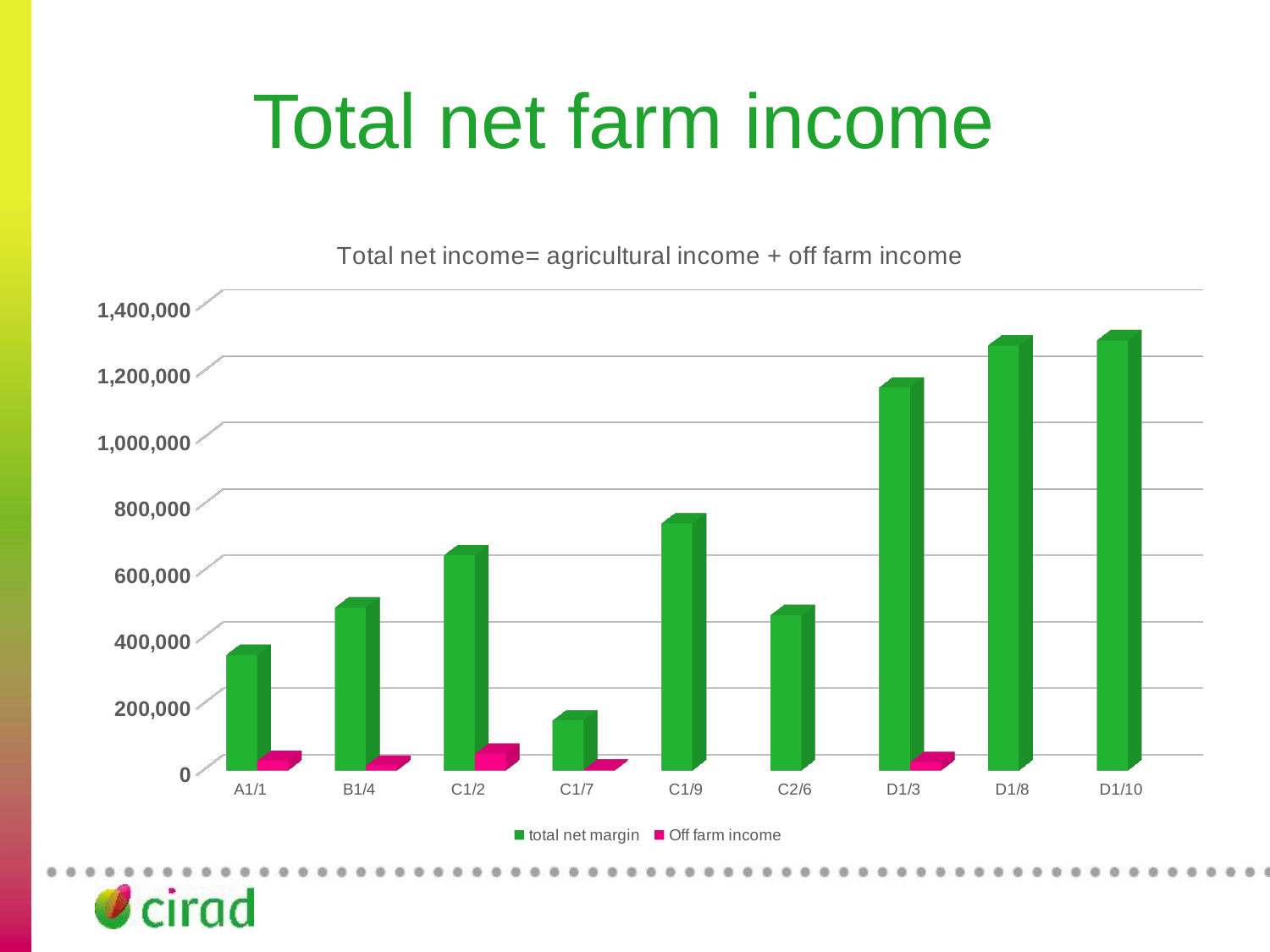
Is the total net margin for C1/7 greater or less than 200,000? less What kind of chart is shown on the slide? bar chart Which series is shown in pink in the chart? Off farm income Is the total net margin for D1/3 greater or less than 1,000,000? greater Is the total net margin for A1/1 greater or less than 200,000? greater What is the title of the chart? Total net income= agricultural income + off farm income How many series does the chart's legend list? 2 Which has the larger total net margin, C1/9 or C2/6? C1/9 How many categories are shown on the x axis of the chart? 9 Which has the larger total net margin, A1/1 or B1/4? B1/4 Which category has the lowest total net margin? C1/7